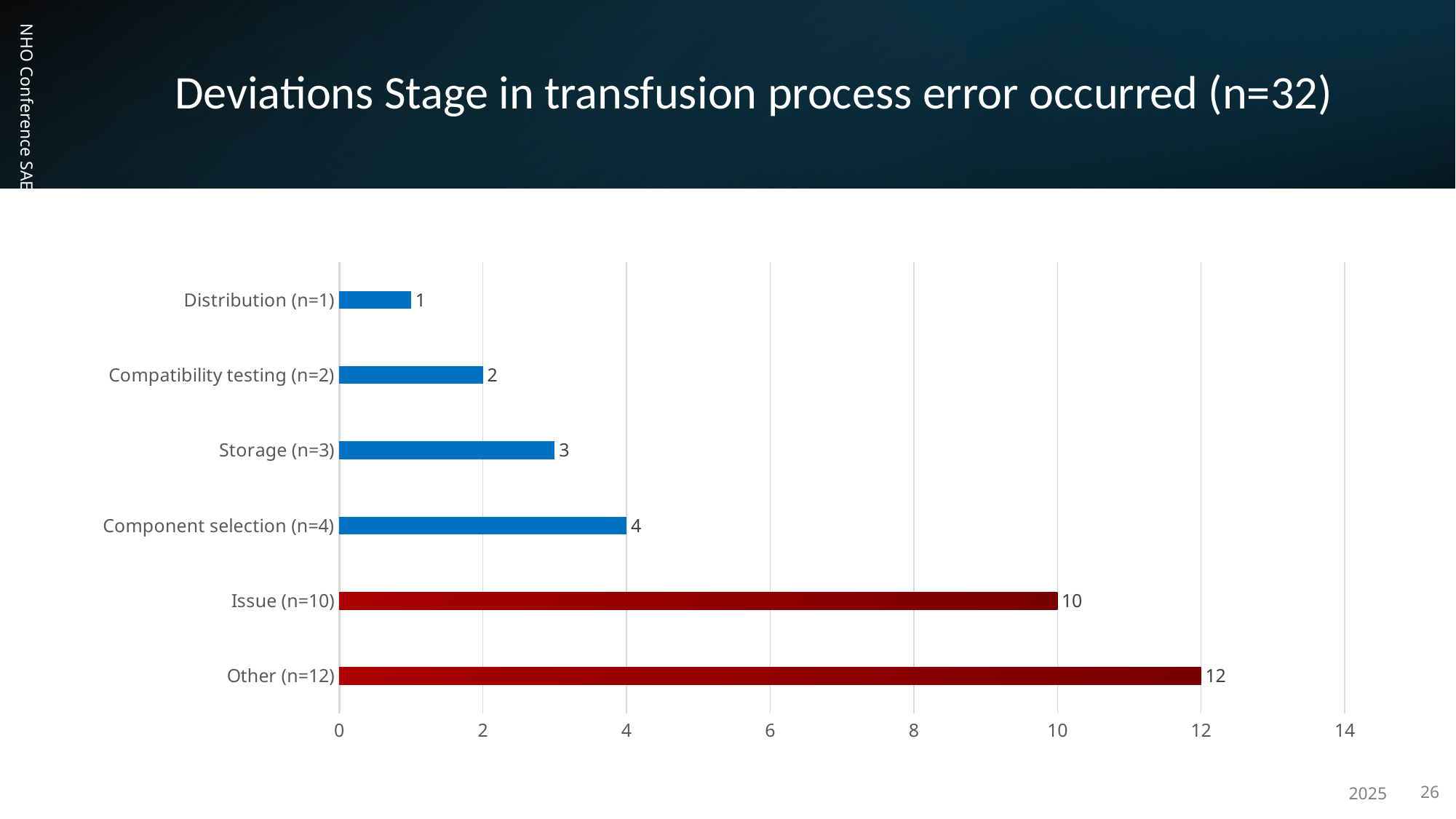
What is the value for Storage (n=3)? 3 Which is larger, the value for Compatibility testing (n=2) or the value for Storage (n=3)? Storage (n=3) Which category has the highest value? Other (n=12) What is the value for Issue (n=10)? 10 What is the value for Component selection (n=4)? 4 What is the difference between the values for Other (n=12) and Issue (n=10)? 2 What is the difference between the values for Component selection (n=4) and Distribution (n=1)? 3 What is the title of the chart? Deviations Stage in transfusion process error occurred (n=32) Which category has the lowest value? Distribution (n=1) How many categories are shown in the chart? 6 What kind of chart is shown on the slide? bar chart Is the value for Issue (n=10) greater or less than 8? greater